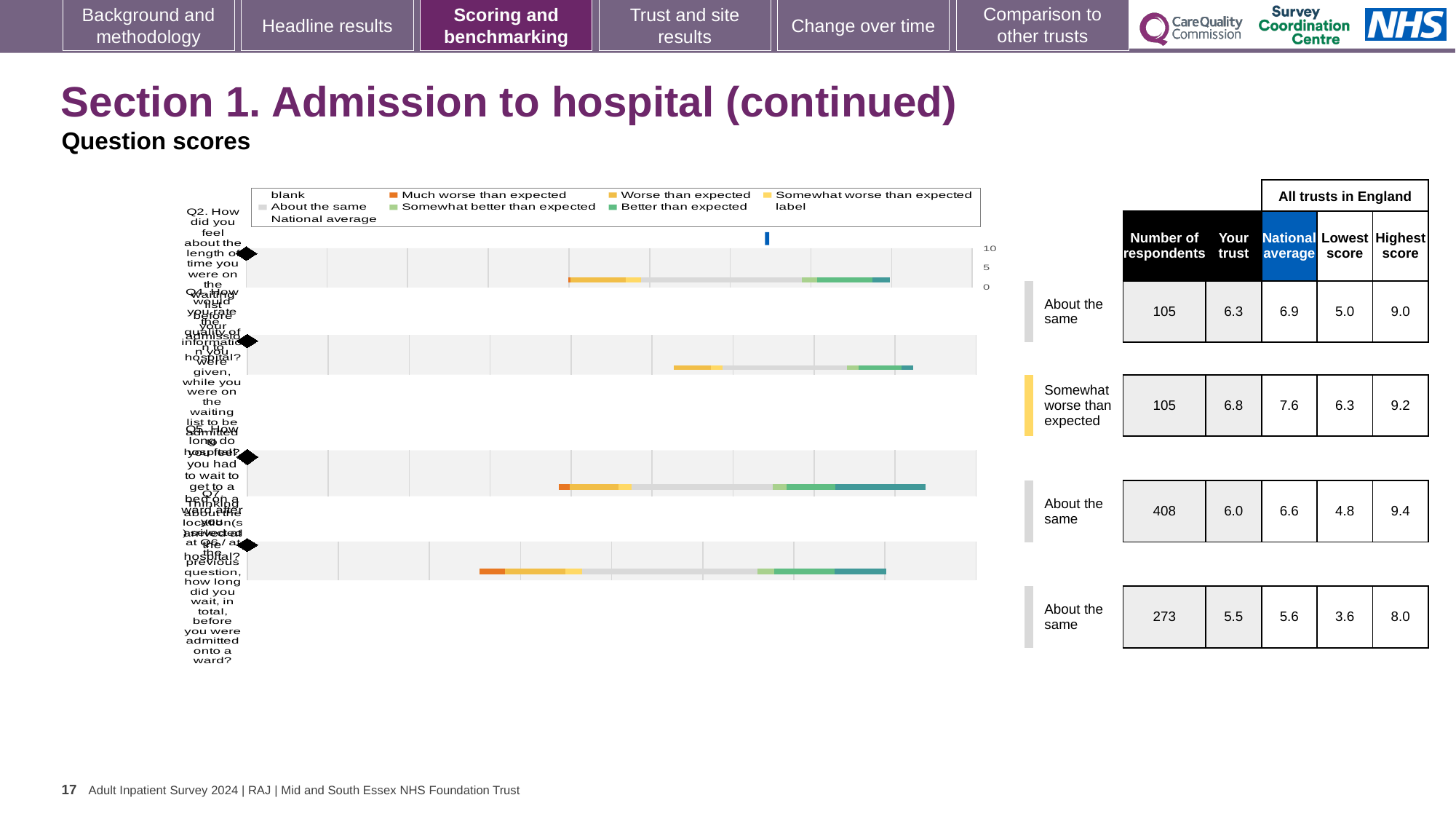
In the table beside the chart, what is the smallest 'Lowest score' value? 3.6 In the table beside the chart, what is the difference between the national average and the 'Your trust' score for the row rated 'Somewhat worse than expected'? 0.8 What kind of chart is shown on the slide? bar chart In the table beside the chart, is the 'Your trust' score for the row with 273 respondents higher or lower than its national average? lower What colour represents 'Much worse than expected' in the chart legend? orange In the table beside the chart, what is the 'Your trust' score for the row with 408 respondents? 6.0 In the table beside the chart, which row has the highest 'Highest score' value? the row with 408 respondents (9.4) In the table beside the chart, what is the national average for the row rated 'Somewhat worse than expected'? 7.6 How many of the four question rows are rated 'About the same'? 3 What is the maximum value shown on the chart's score axis? 10 How many question rows (bars) are plotted in the chart? 4 In the table beside the chart, how many respondents are listed for the row rated 'Somewhat worse than expected'? 105